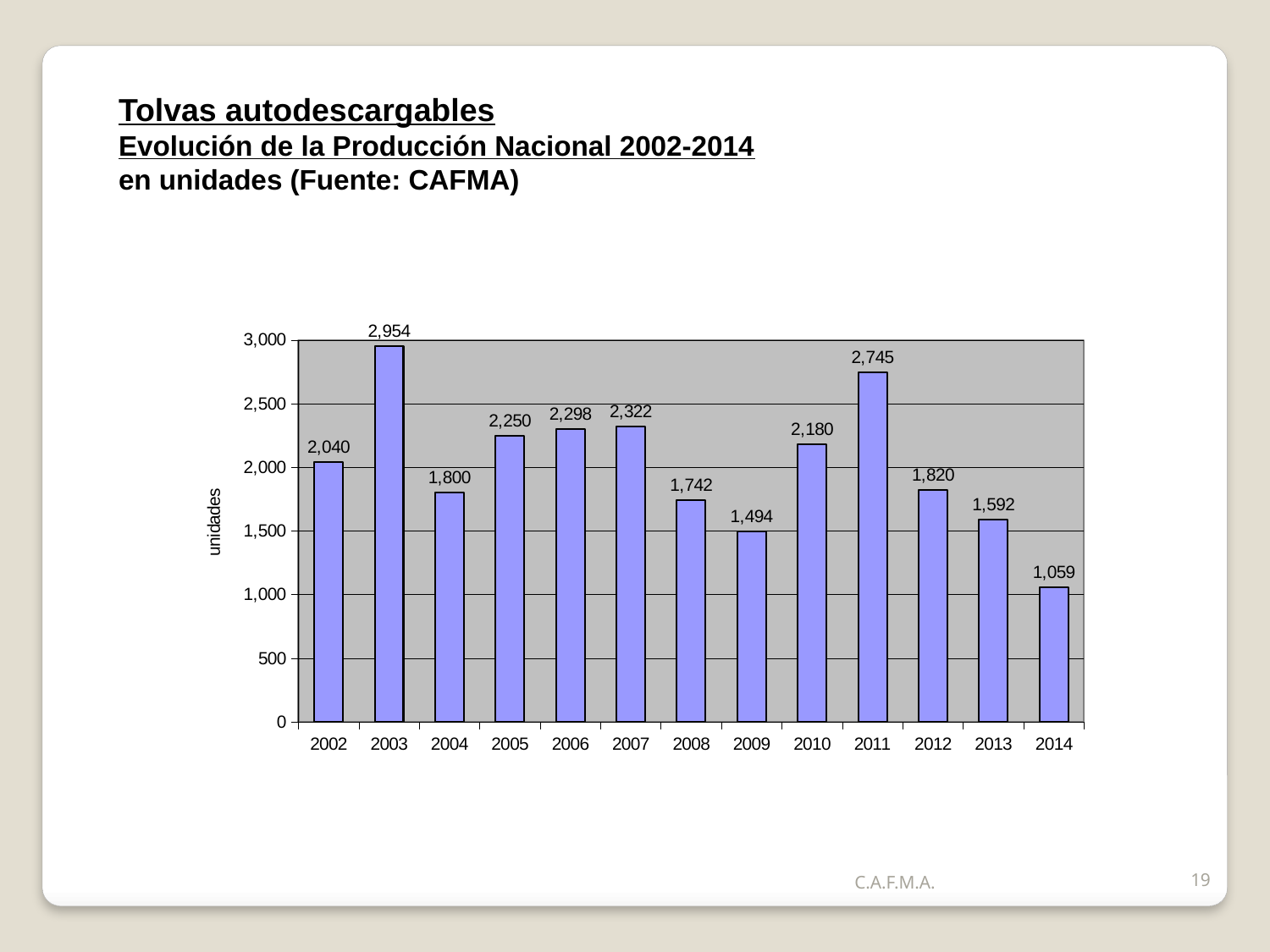
What was the production in 2009? 1,494 Is the value for 2008 greater or less than 2,000? less What is the label on the vertical axis? unidades What is the difference between the 2003 and 2002 values? 914 What was the production of tolvas autodescargables in 2003? 2,954 Which year had the lowest production? 2014 How many years are shown on the x axis? 13 What kind of chart is shown on the slide? Bar chart Which year had the highest production? 2003 Which year had higher production, 2010 or 2013? 2010 What value is shown for 2014? 1,059 What is the difference between the 2011 and 2012 values? 925